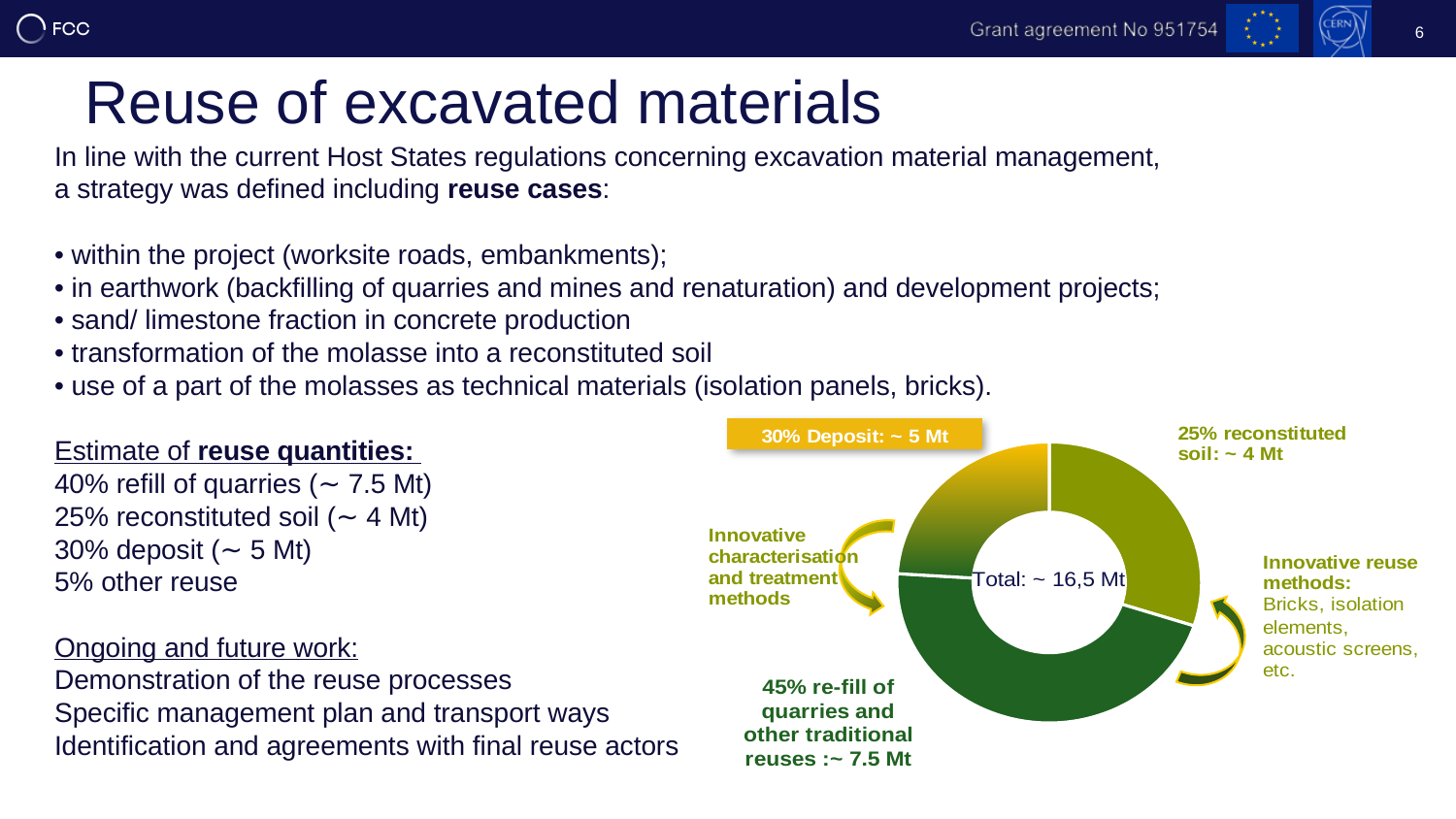
What kind of chart is shown on the slide? pie chart (donut) What percentage of the chart is labelled as reconstituted soil? 25% What percentage of the excavated material is shown as deposit in the chart? 30% Which is larger in the chart: the deposit segment or the reconstituted soil segment? deposit Which segment of the chart is the largest? re-fill of quarries and other traditional reuses What percentage is labelled as re-fill of quarries and other traditional reuses in the chart? 45% By how many percentage points does the re-fill of quarries segment exceed the deposit segment? 15 percentage points What total is printed in the centre of the donut chart? ~ 16,5 Mt What colour is the deposit segment of the donut chart? yellow fading to green (gradient) What quantity in Mt is printed for the deposit segment of the chart? ~ 5 Mt Which segment of the chart is the smallest? reconstituted soil How many segments does the donut chart have? 3